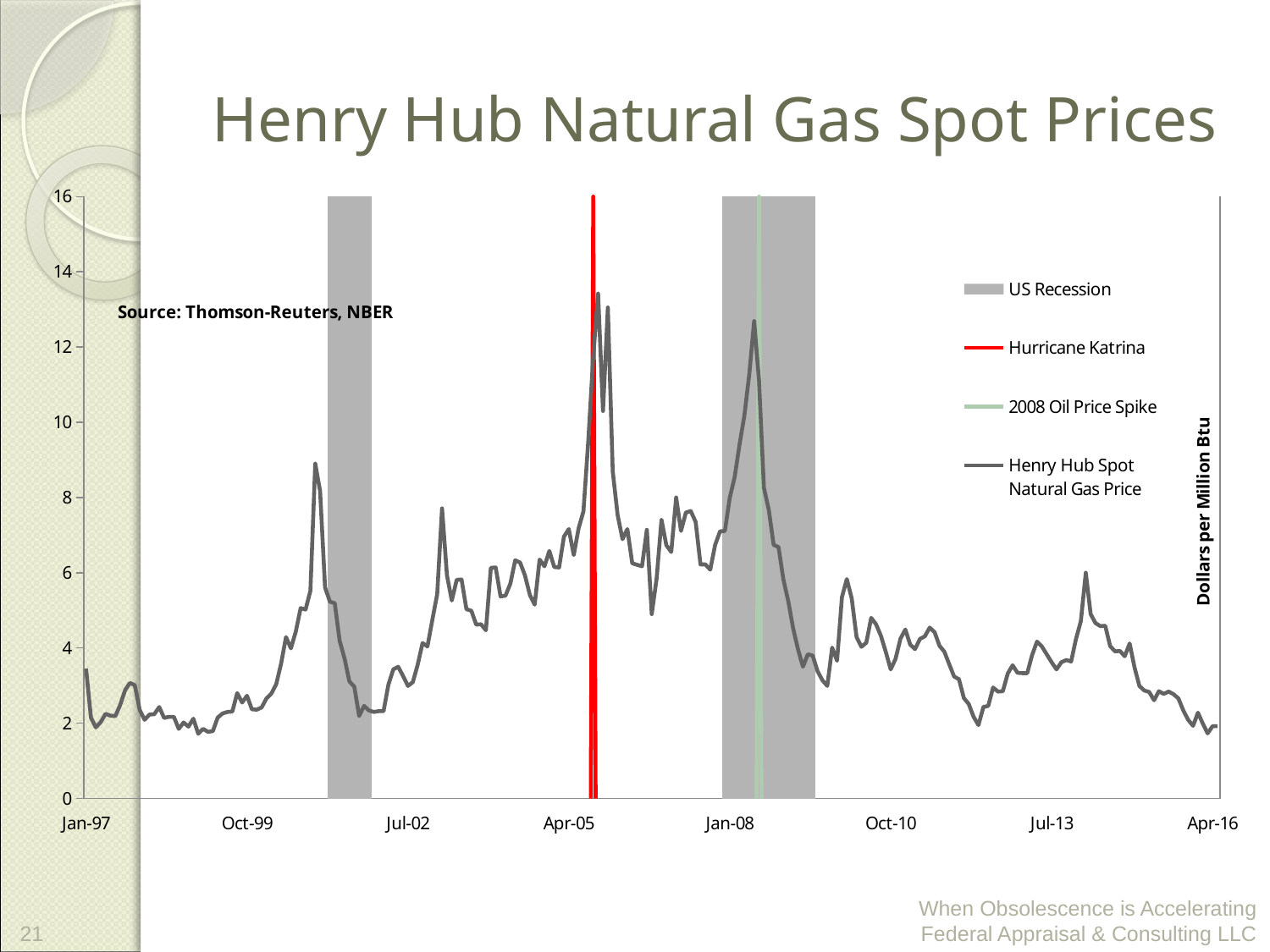
What kind of chart is shown on the slide? line chart What is the label on the vertical axis of the chart? Dollars per Million Btu Does the Henry Hub Spot Natural Gas Price generally rise or fall from its 2008 peak to Apr-16? fall Is the peak of the Henry Hub Spot Natural Gas Price shortly after Hurricane Katrina greater or less than 12? greater How many US Recession shaded bands appear on the chart? 2 How many date labels are shown on the horizontal axis? 8 Is the Henry Hub Spot Natural Gas Price at Jan-97 greater or less than 4? less Which is higher: the Henry Hub Spot Natural Gas Price peak shortly after Hurricane Katrina or the peak around Jul-13? the peak shortly after Hurricane Katrina How many entries does the chart legend list? 4 Is the peak of the Henry Hub Spot Natural Gas Price around the 2008 Oil Price Spike greater or less than 10? greater What is the title of the chart? Henry Hub Natural Gas Spot Prices